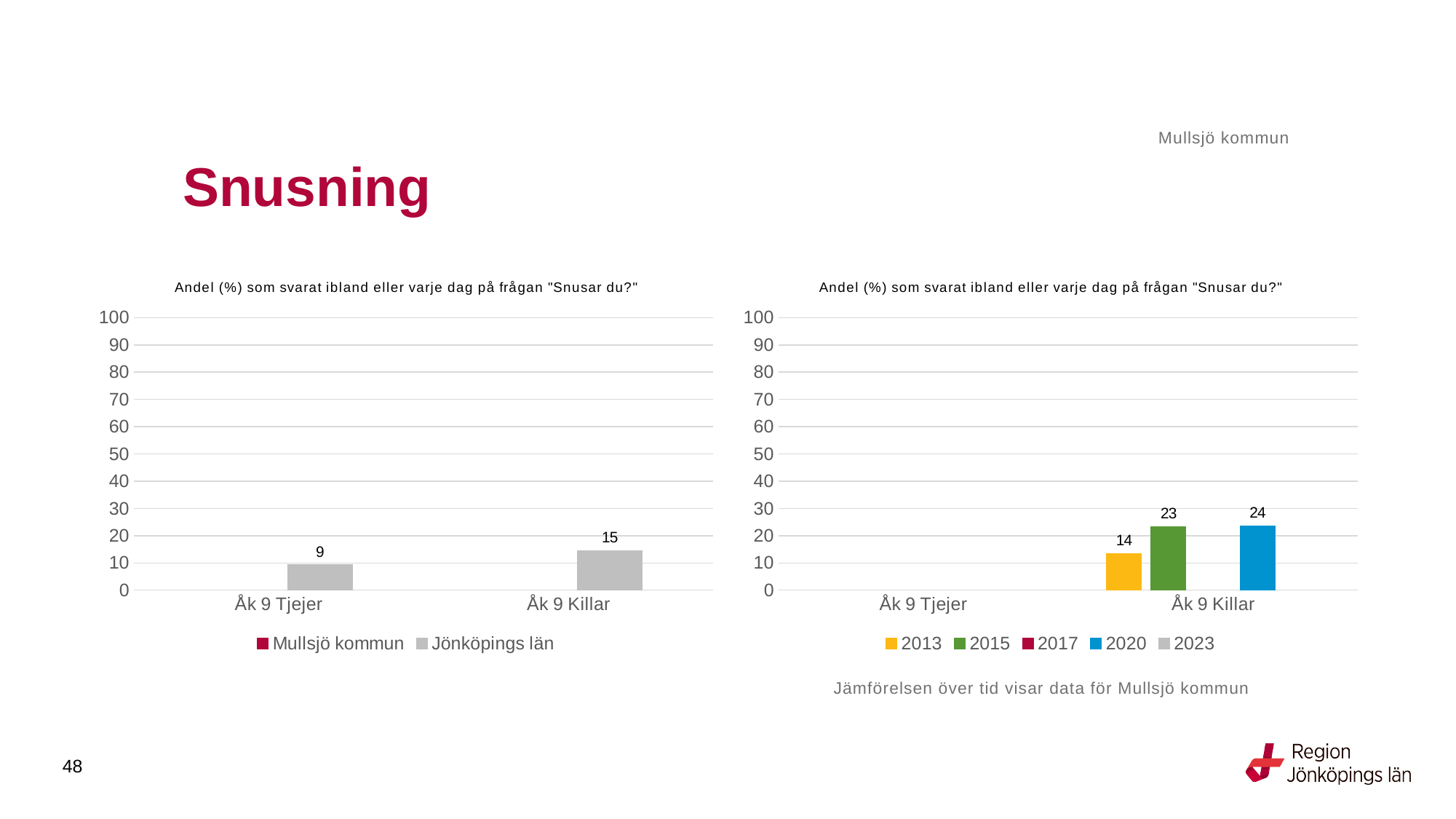
In the right chart, what is the value for 2013 for Åk 9 Killar? 14 In the right chart, what is the value for 2015 for Åk 9 Killar? 23 How many series does the legend of the right chart list? 5 What kind of chart is the left chart? bar chart In the right chart, what is the value for 2020 for Åk 9 Killar? 24 In the right chart, which year has the lowest value for Åk 9 Killar? 2013 In the left chart, what is the value for Jönköpings län for Åk 9 Tjejer? 9 In the left chart, what is the value for Jönköpings län for Åk 9 Killar? 15 In the left chart, what is the difference between the Jönköpings län values for Åk 9 Killar and Åk 9 Tjejer? 6 How many series does the legend of the left chart list? 2 In the right chart, what is the difference between the 2020 and 2013 values for Åk 9 Killar? 10 In the left chart, which category has the higher Jönköpings län value, Åk 9 Tjejer or Åk 9 Killar? Åk 9 Killar